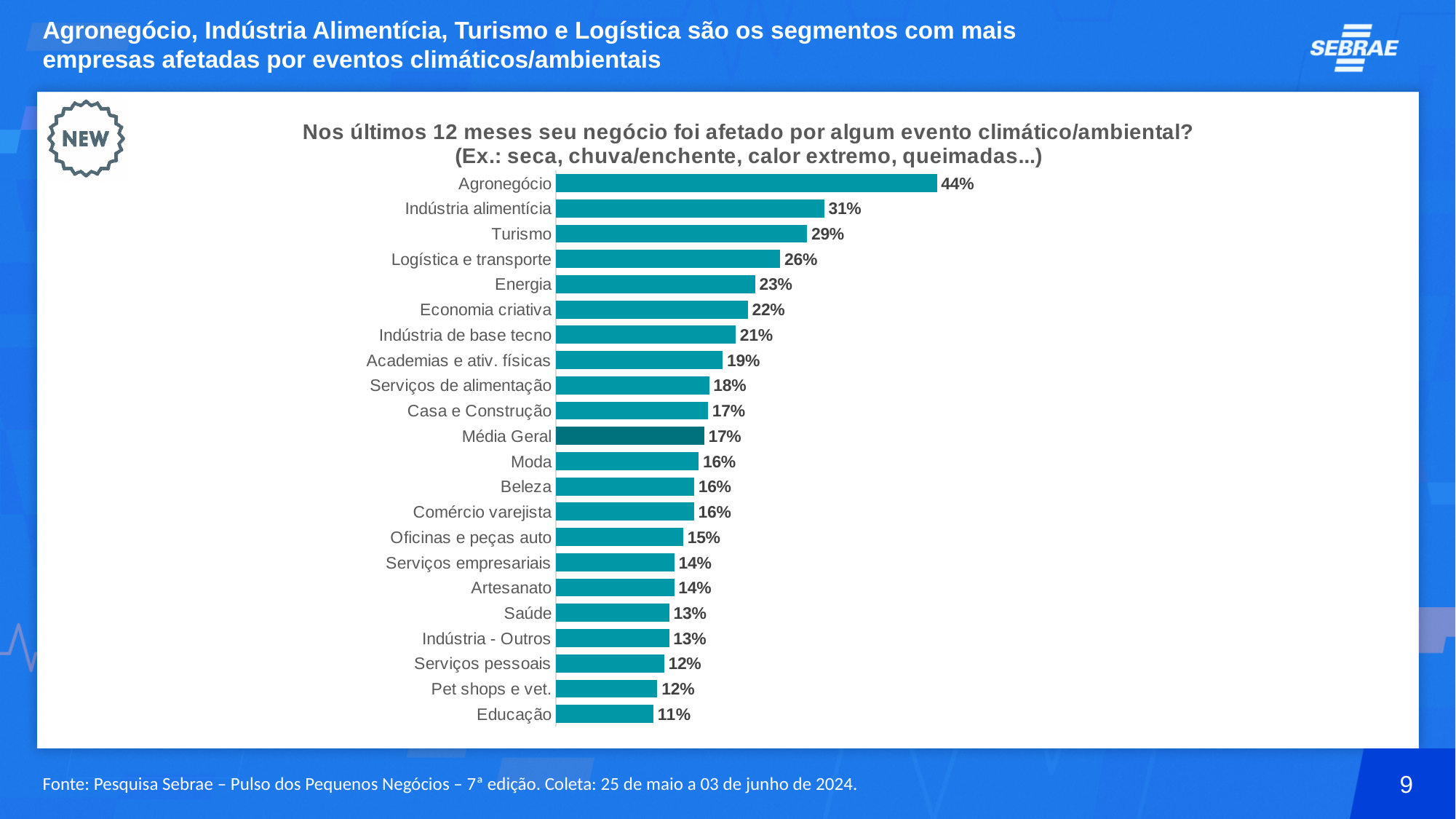
How many categories are shown in the chart? 22 What is the difference between the values for Energia and Saúde? 10% Which category has the lowest value? Educação What is the value for Média Geral? 17% Which bar is drawn in a darker colour than the others? Média Geral What is the value for Turismo? 29% Which is larger, the value for Logística e transporte or the value for Economia criativa? Logística e transporte What kind of chart is shown on the slide? Bar chart What is the value for Agronegócio? 44% Which category has the highest value? Agronegócio What is the difference between the values for Agronegócio and Indústria alimentícia? 13% What is the value for Educação? 11%